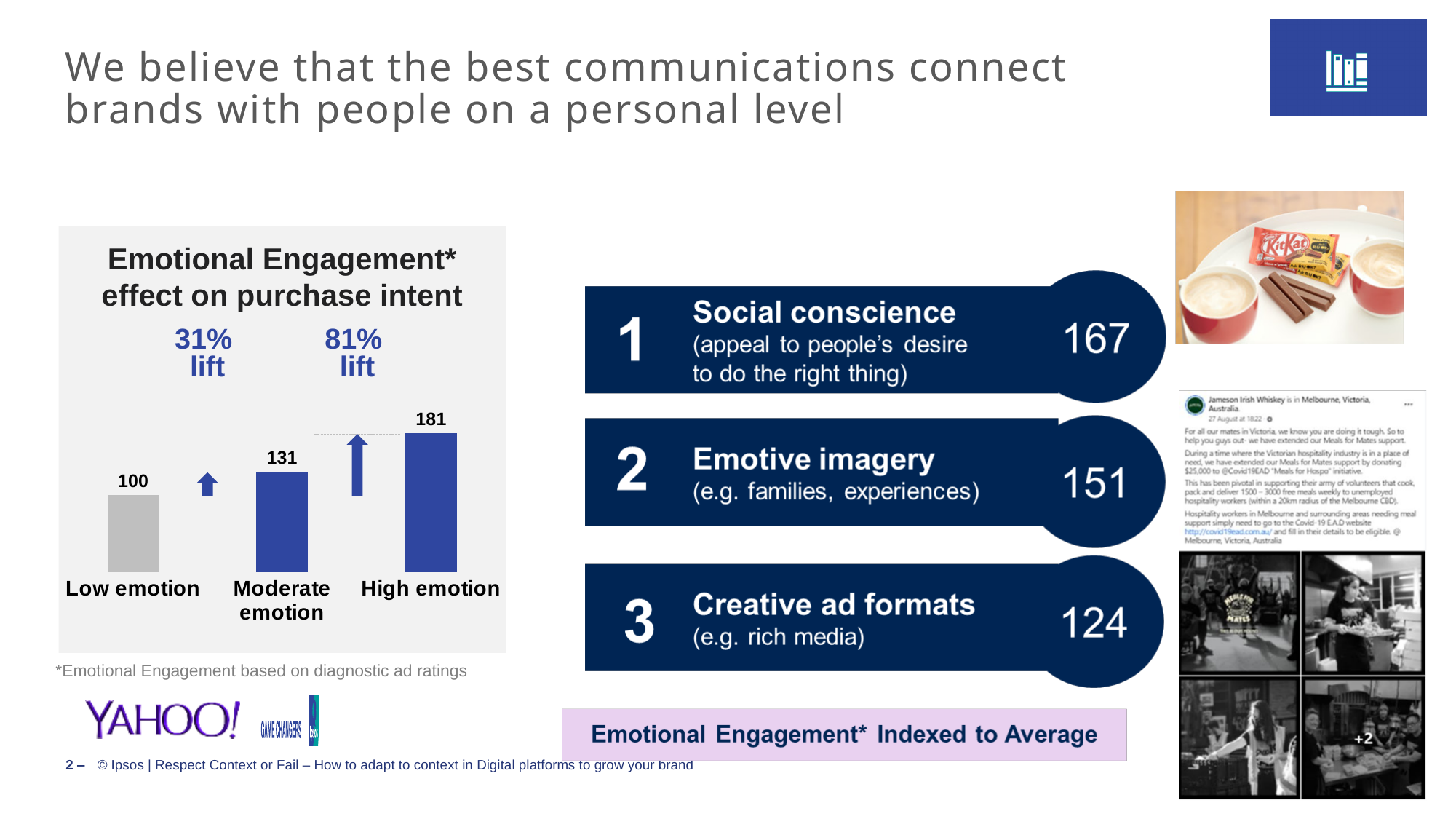
In the "Emotional Engagement* effect on purchase intent" chart, which is larger, Moderate emotion or High emotion? High emotion In the "Emotional Engagement* effect on purchase intent" chart, do the values rise or fall from Low emotion to High emotion? Rise In the "Emotional Engagement* effect on purchase intent" chart, which category has the lowest value? Low emotion In the "Emotional Engagement* effect on purchase intent" chart, what is the value for High emotion? 181 In the "Emotional Engagement* effect on purchase intent" chart, what lift percentage is shown above the High emotion bar? 81% lift How many categories are shown in the "Emotional Engagement* effect on purchase intent" chart? 3 What type of chart is the "Emotional Engagement* effect on purchase intent" chart? Bar chart In the "Emotional Engagement* effect on purchase intent" chart, what is the difference between the Moderate emotion and Low emotion values? 31 In the "Emotional Engagement* effect on purchase intent" chart, what is the value for Low emotion? 100 In the "Emotional Engagement* effect on purchase intent" chart, what is the value for Moderate emotion? 131 In the "Emotional Engagement* effect on purchase intent" chart, what is the difference between the High emotion and Low emotion values? 81 In the "Emotional Engagement* effect on purchase intent" chart, which category has the highest value? High emotion